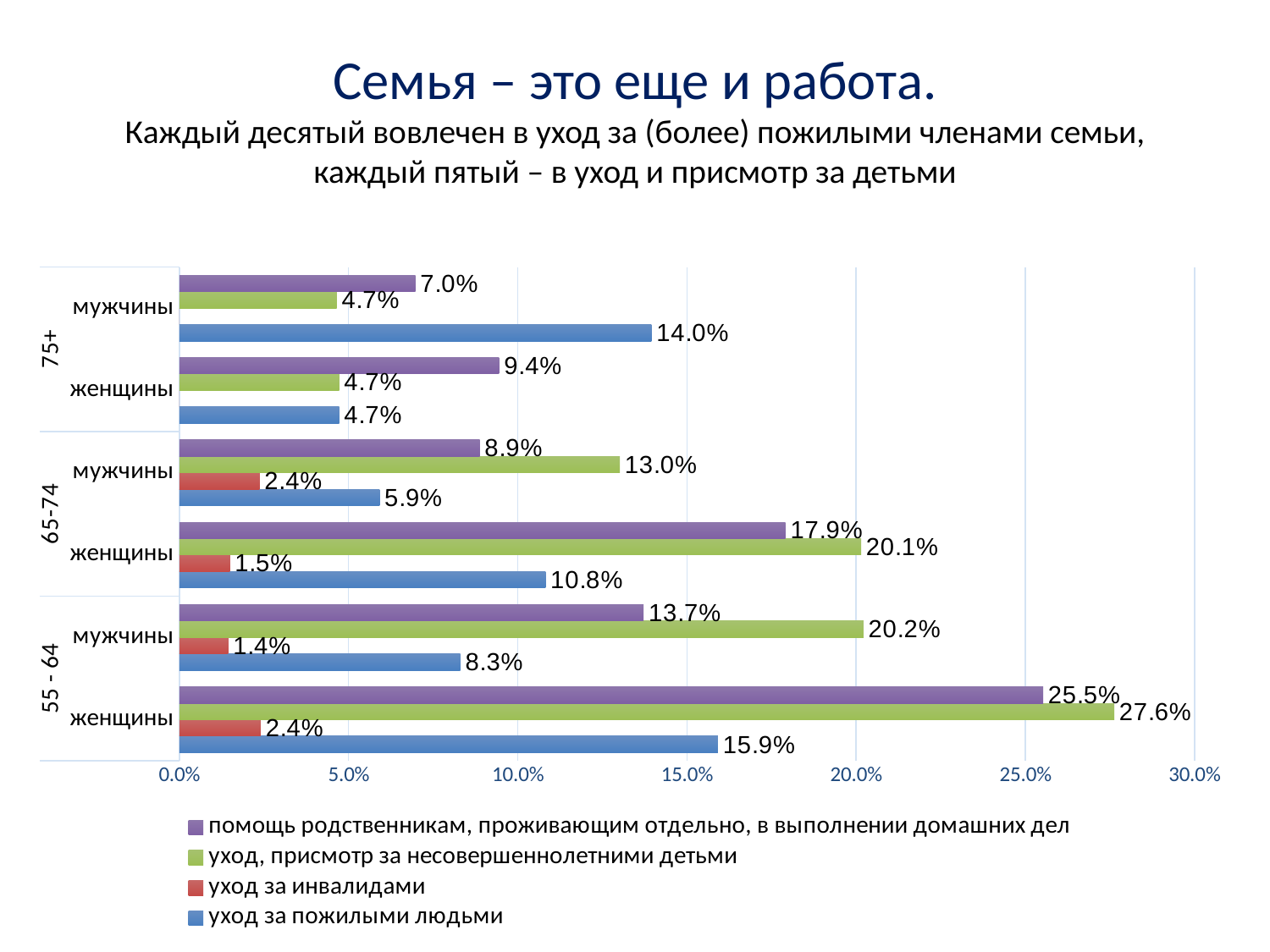
Which group has the lowest value for 'уход за пожилыми людьми'? женщины 75+ Which group has the highest value for 'помощь родственникам, проживающим отдельно, в выполнении домашних дел'? женщины 55 - 64 What is the value of 'уход, присмотр за несовершеннолетними детьми' for женщины aged 55 - 64? 27.6% Is the value of 'уход за пожилыми людьми' for женщины aged 55 - 64 greater or less than 15.0%? greater What is the value of 'уход за инвалидами' for женщины aged 65-74? 1.5% What is the difference between 'уход, присмотр за несовершеннолетними детьми' for женщины 55 - 64 and мужчины 55 - 64? 7.4% How many series does the legend list? 4 What is the value of 'помощь родственникам, проживающим отдельно, в выполнении домашних дел' for мужчины aged 65-74? 8.9% Which is larger for женщины aged 65-74: 'уход за пожилыми людьми' or 'помощь родственникам, проживающим отдельно, в выполнении домашних дел'? помощь родственникам, проживающим отдельно, в выполнении домашних дел What is the value of 'уход за пожилыми людьми' for мужчины aged 75+? 14.0% What colour represents 'уход за инвалидами' in the chart? red What type of chart is shown on the slide? bar chart